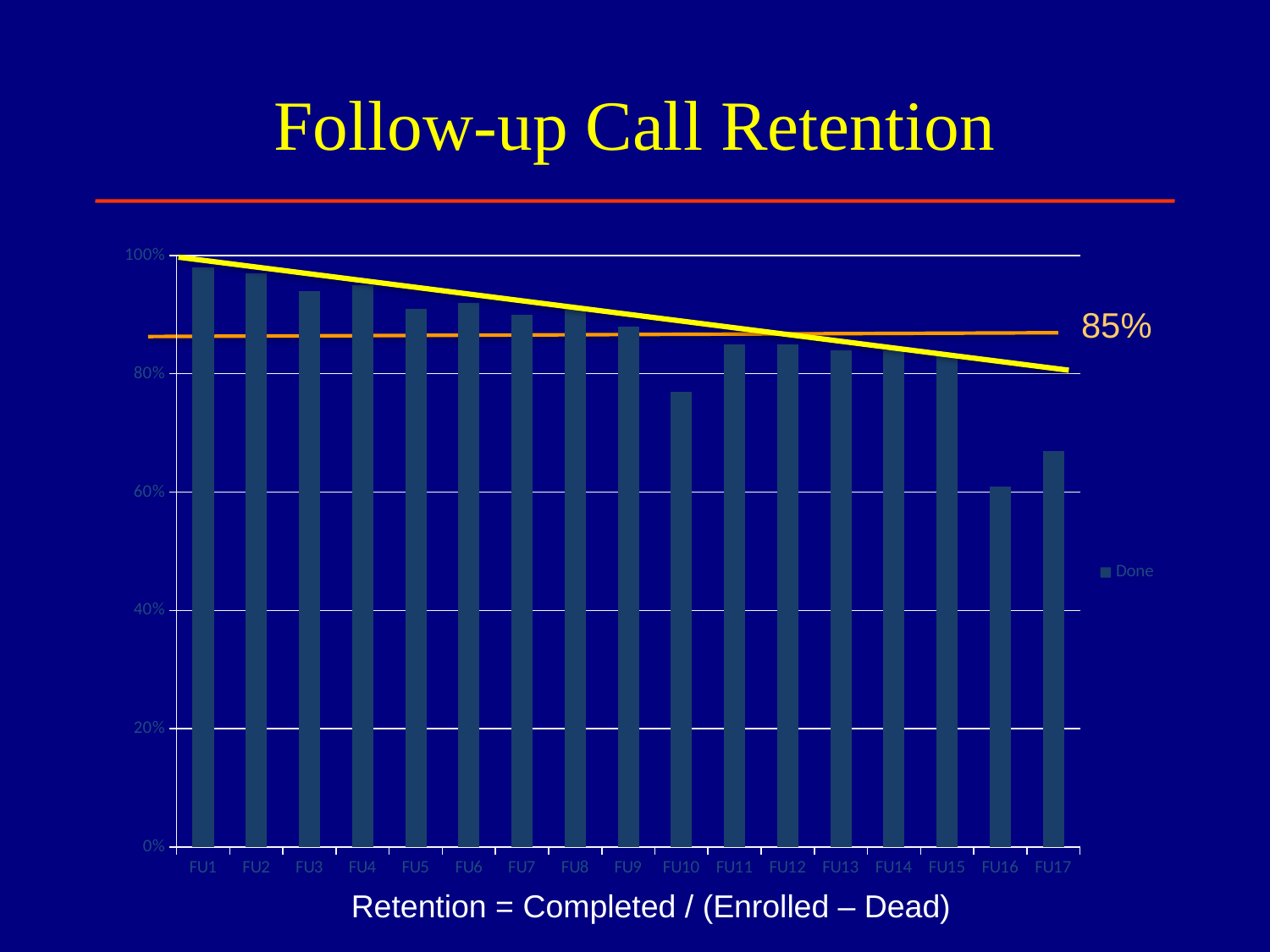
What percentage is labelled on the orange horizontal reference line? 85% What kind of chart is shown on the slide? bar chart Is the value for FU10 greater or less than 80%? less How many follow-up categories are plotted along the x axis? 17 Which follow-up call has the lowest retention? FU16 How many series does the legend list? 1 Do the retention values generally rise or fall from FU1 to FU17? fall Is the value for FU17 greater or less than 80%? less Is the value for FU5 greater or less than 80%? greater Which is larger, the value for FU16 or the value for FU17? FU17 Which is larger, the value for FU1 or the value for FU10? FU1